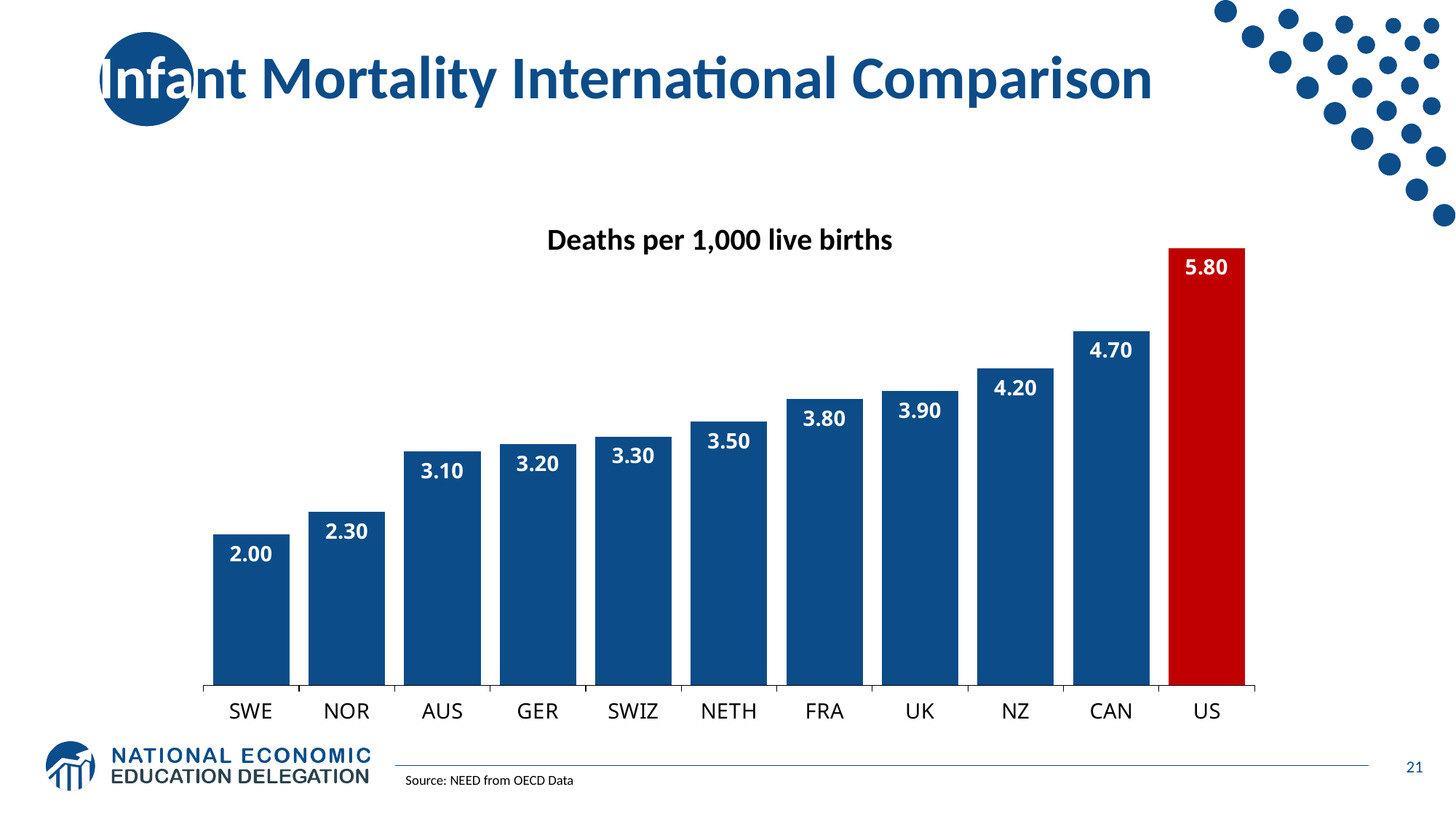
What is the title of the chart? Deaths per 1,000 live births Do the values rise or fall from left to right along the x axis? rise What kind of chart is shown on the slide? bar chart Which country has the highest value? US What is the value for the US? 5.80 What is the difference between the values for NOR and SWE? 0.30 How many countries are shown in the chart? 11 Which country has the lowest value? SWE Which is larger, the value for FRA or the value for SWIZ? FRA What is the difference between the values for the US and CAN? 1.10 What is the value for NETH? 3.50 What is the value for GER? 3.20